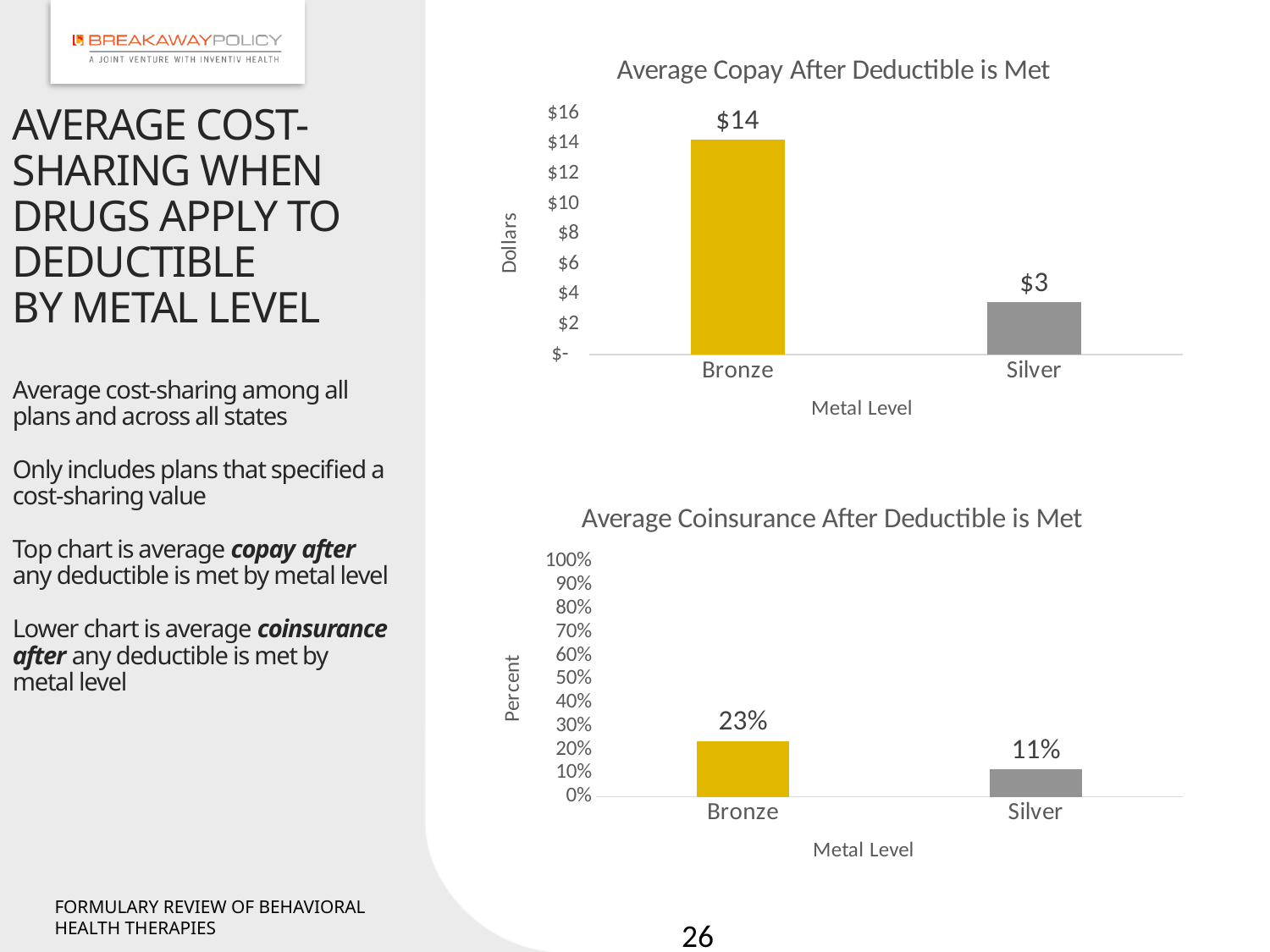
In the 'Average Coinsurance After Deductible is Met' chart, what is the difference between the Bronze and Silver values? 12% In the 'Average Coinsurance After Deductible is Met' chart, is the value for Bronze greater or less than 50%? less In the 'Average Coinsurance After Deductible is Met' chart, what is the value for Bronze? 23% In the 'Average Coinsurance After Deductible is Met' chart, what is the value for Silver? 11% In the 'Average Copay After Deductible is Met' chart, how many metal levels are shown? 2 In the 'Average Copay After Deductible is Met' chart, which metal level has the highest average copay? Bronze In the 'Average Copay After Deductible is Met' chart, what is the value for Silver? $3 What is the y-axis label of the 'Average Coinsurance After Deductible is Met' chart? Percent In the 'Average Copay After Deductible is Met' chart, what is the difference between the Bronze and Silver values? $11 In the 'Average Coinsurance After Deductible is Met' chart, which metal level has the lowest average coinsurance? Silver In the 'Average Copay After Deductible is Met' chart, what is the value for Bronze? $14 What kind of chart is the 'Average Copay After Deductible is Met' chart? bar chart